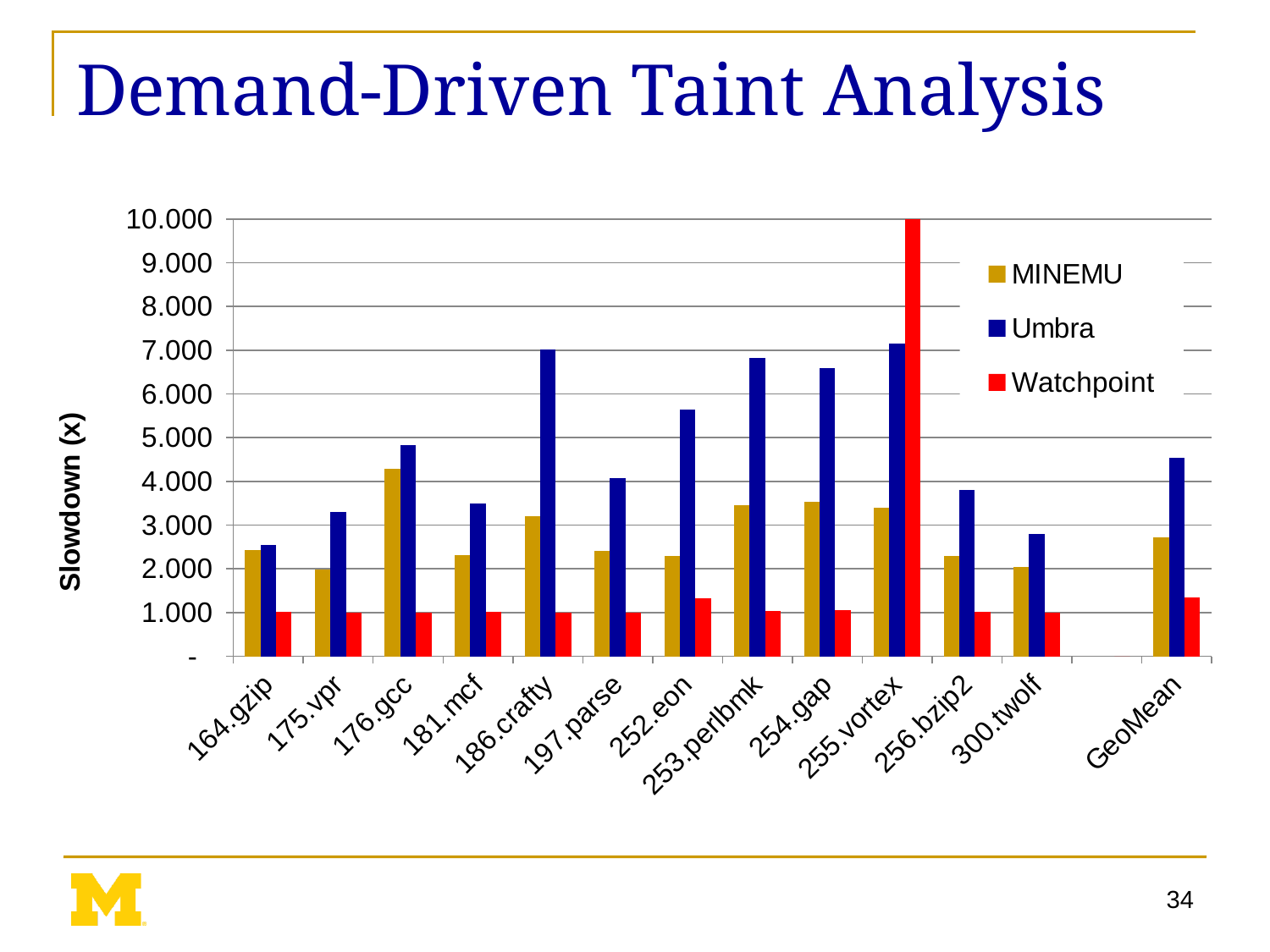
For 252.eon, which is larger: the Umbra value or the MINEMU value? Umbra Which category has the highest MINEMU value? 176.gcc What kind of chart is shown on the slide? bar chart How many categories are shown along the x axis? 13 Which series is shown in red? Watchpoint Is the Umbra value for 186.crafty greater or less than 6.000? greater Is the Watchpoint value for 255.vortex greater or less than 9.000? greater Which category has the highest Watchpoint value? 255.vortex How many series does the legend list? 3 What is the label of the y axis? Slowdown (x) Is the Umbra value for GeoMean greater or less than 4.000? greater